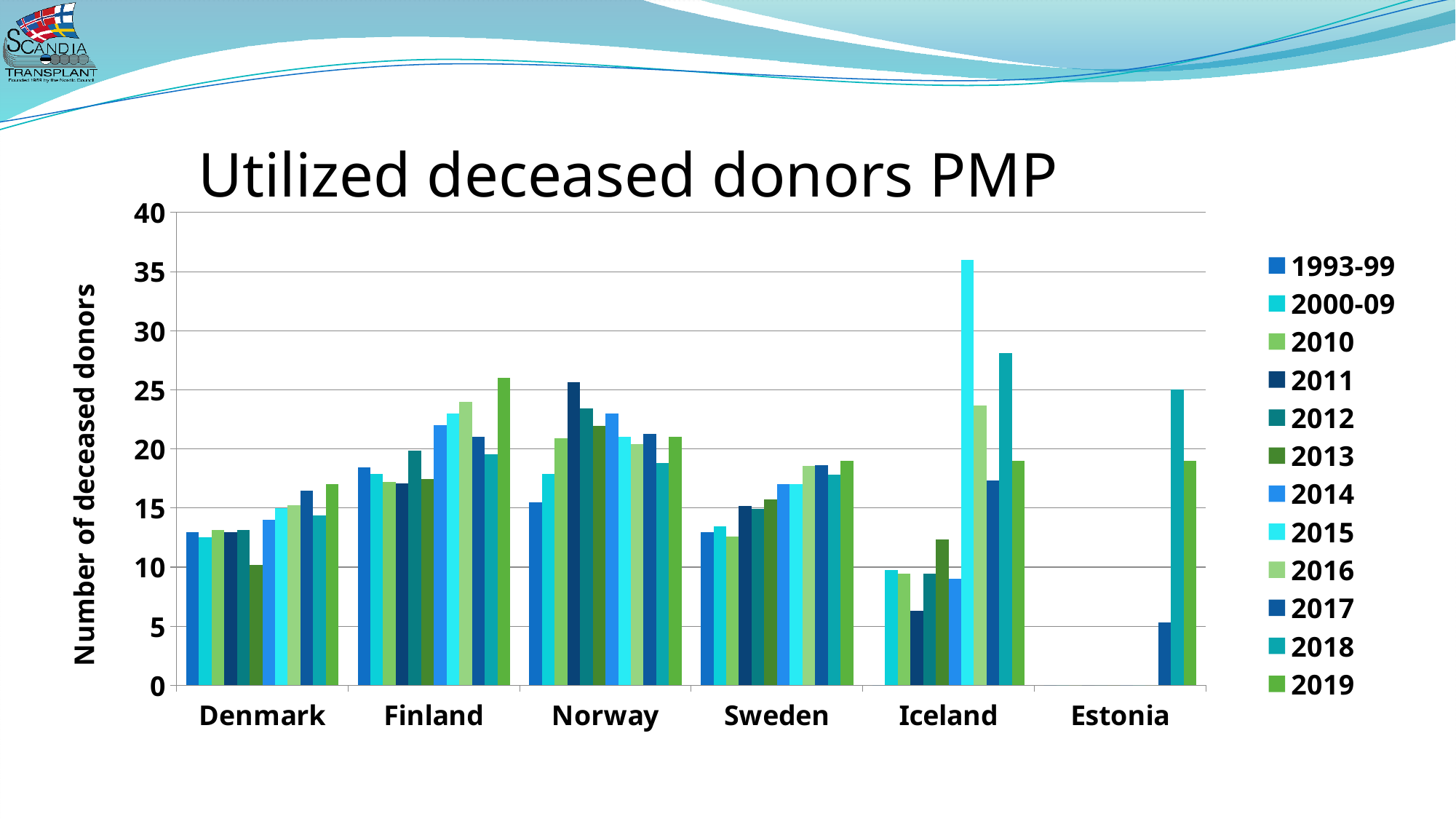
What is the title of the y axis? Number of deceased donors How many series does the legend list? 12 Which is larger for 2011: Norway or Denmark? Norway Is the value for Sweden in 2010 greater or less than 15? less Which country has the tallest bar in the chart? Iceland What kind of chart is shown on the slide? bar chart How many countries are shown on the x axis of the chart? 6 Is the value for Denmark in 2013 greater or less than 15? less Is the value for Iceland in 2018 greater or less than 25? greater Which is larger for Estonia: the 2018 value or the 2019 value? 2018 Which series has the lowest value for Denmark? 2013